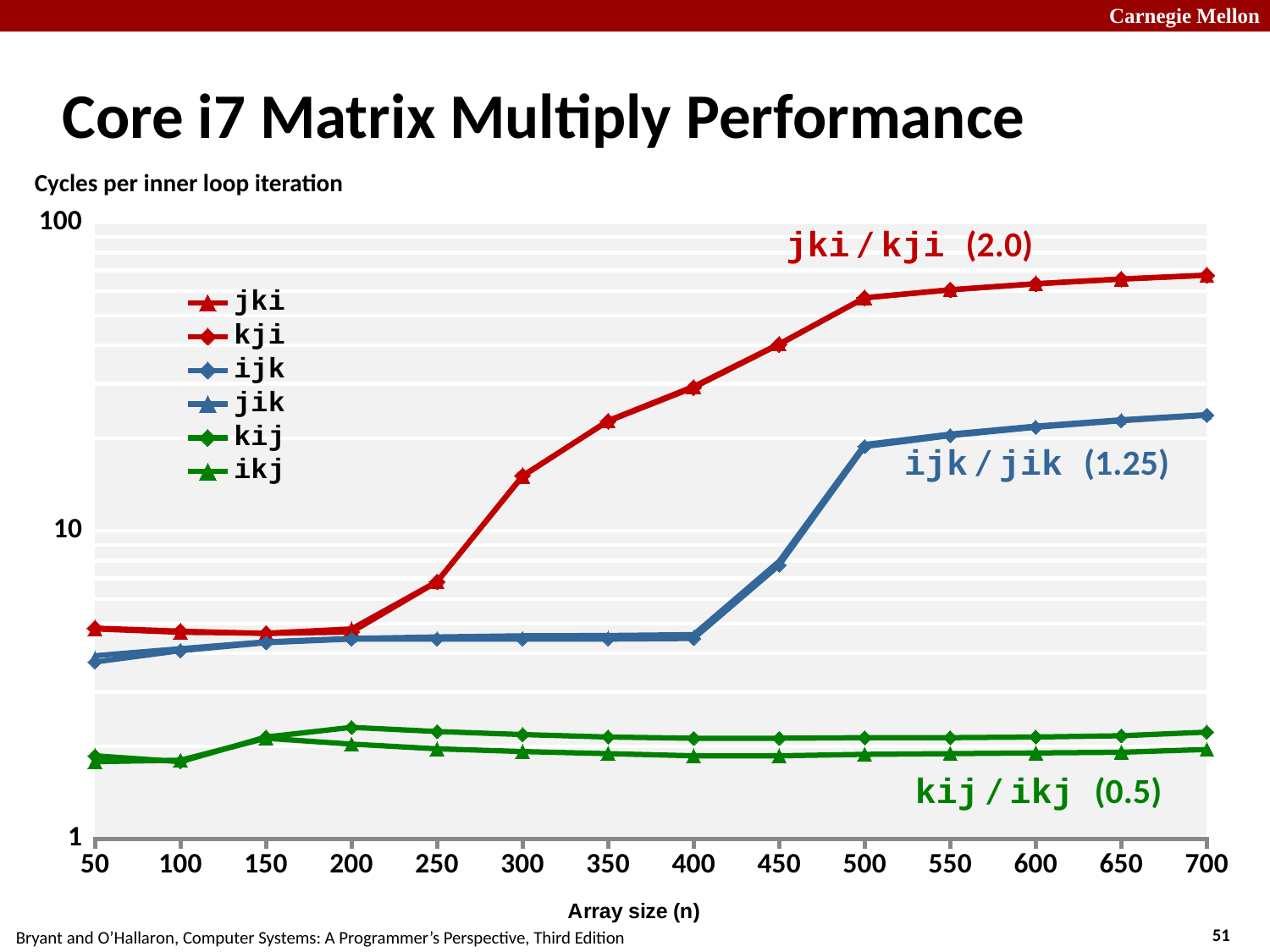
At array size 700, which is larger, the value for jki or the value for kij? jki Do the values for jki rise or fall as array size increases from 50 to 700? rise Is the value for ijk at array size 300 greater or less than 10? less Is the value for jki at array size 300 greater or less than 10? greater How many array size values are plotted along the x axis? 14 What kind of chart is shown on the slide? line chart Which pair of series has the lowest values at array size 700? kij / ikj What is the x-axis title of the chart? Array size (n) How many series does the legend list? 6 What quantity does the y axis measure, according to the label above the chart? Cycles per inner loop iteration Is the value for kij at array size 700 greater or less than 10? less